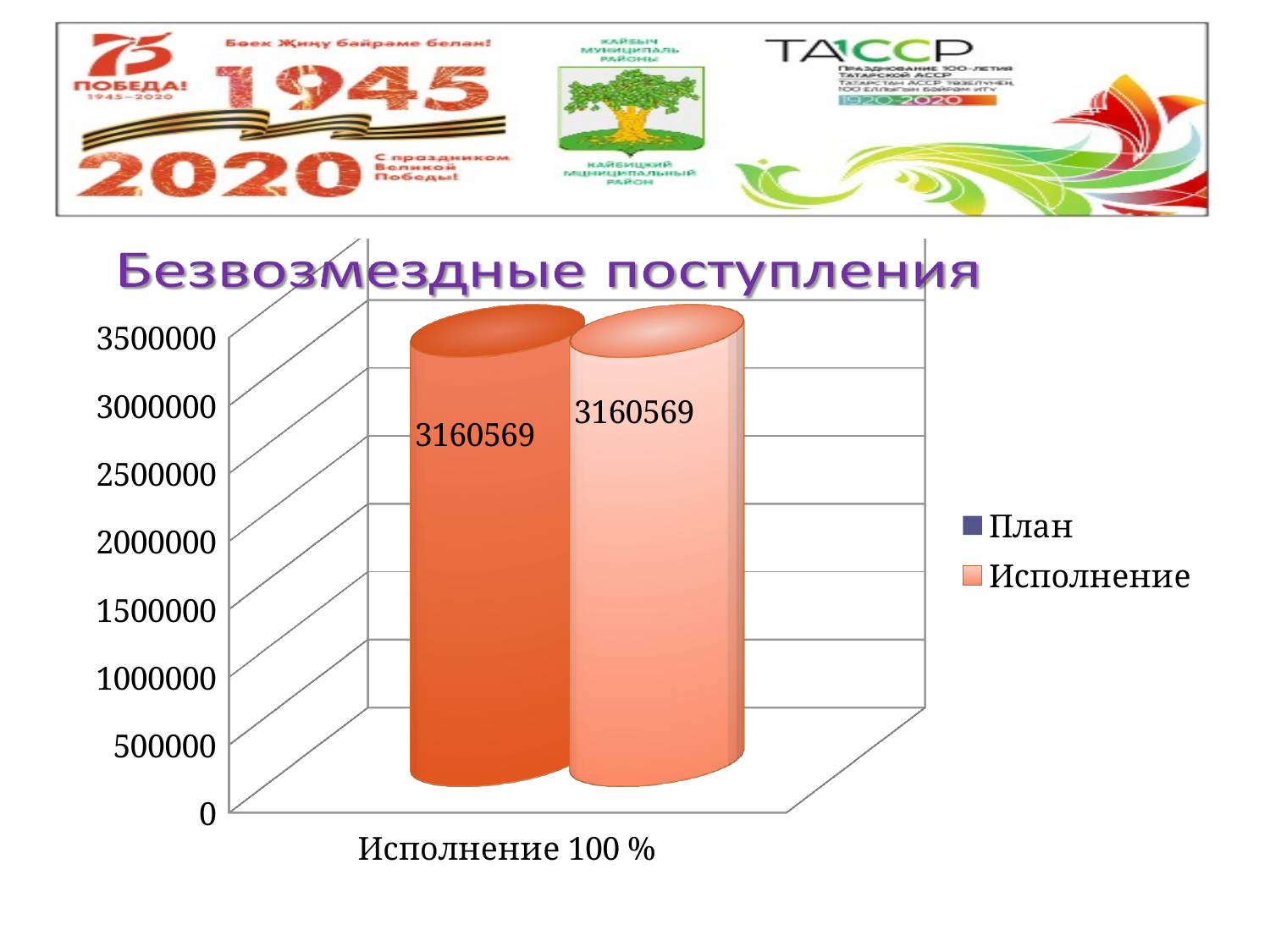
What is the difference between the План and Исполнение values? 0 What is the highest value shown on the y axis? 3500000 How many categories are shown on the x axis? 1 What is the value of the План series on the chart? 3160569 Is the value for Исполнение greater or less than 3500000? less How many series does the legend list? 2 Is the value for План greater or less than 3000000? greater What is the category label shown on the x axis? Исполнение 100 % What is the value of the Исполнение series on the chart? 3160569 What kind of chart is shown on the slide? bar chart What is the title of the chart? Безвозмездные поступления